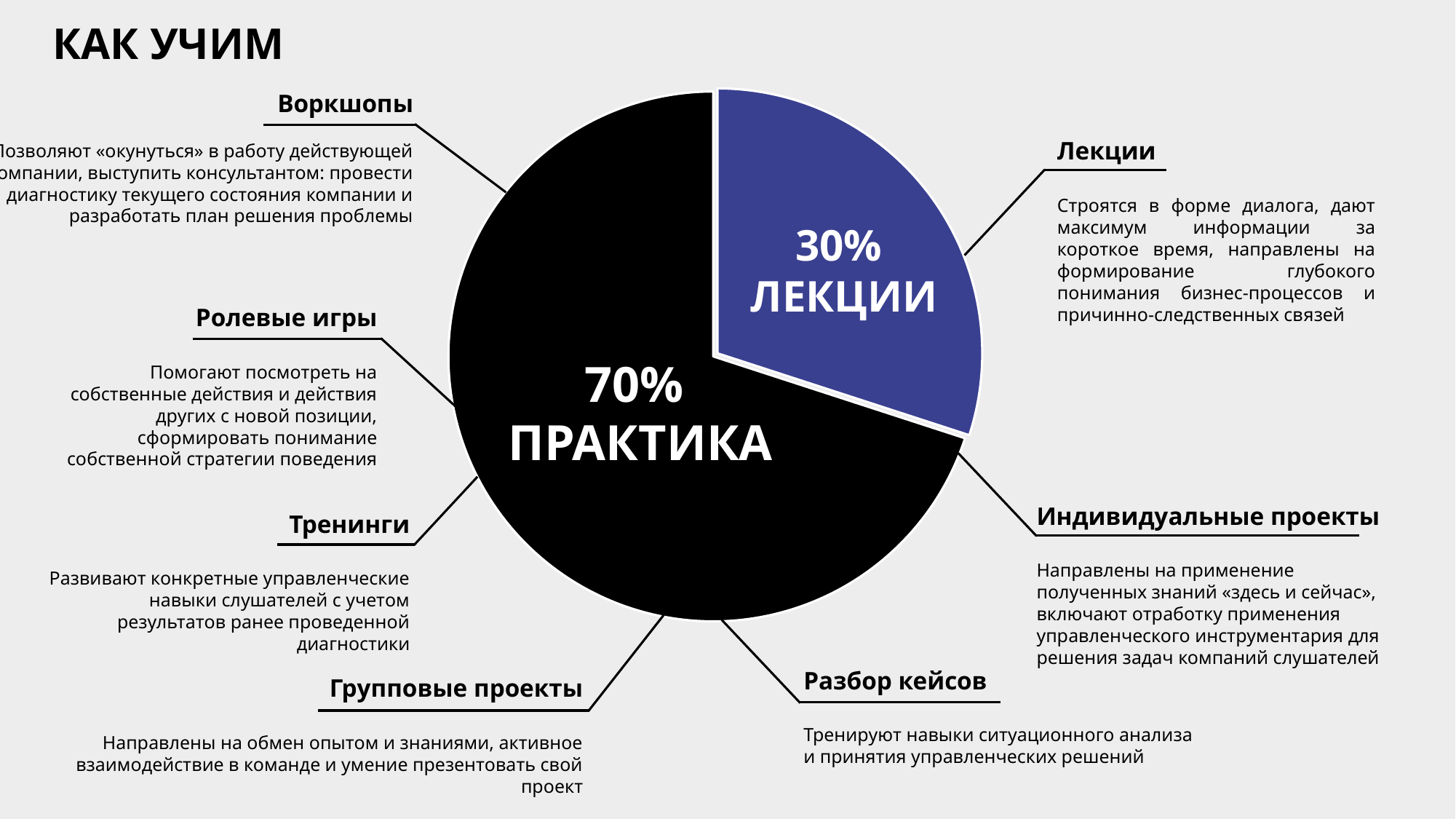
How many slices does the pie chart have? 2 Which slice of the pie chart is the smallest? ЛЕКЦИИ Which is larger in the pie chart, ПРАКТИКА or ЛЕКЦИИ? ПРАКТИКА What share of the pie chart is labelled ПРАКТИКА? 70% What is the combined share of the ПРАКТИКА and ЛЕКЦИИ slices? 100% By how many percentage points does the ПРАКТИКА slice exceed the ЛЕКЦИИ slice? 40% What share of the pie chart is labelled ЛЕКЦИИ? 30% What is the title of the slide containing the pie chart? КАК УЧИМ Which slice of the pie chart is the largest? ПРАКТИКА What colour is the ЛЕКЦИИ slice of the pie chart? blue What kind of chart is shown on the slide? pie chart